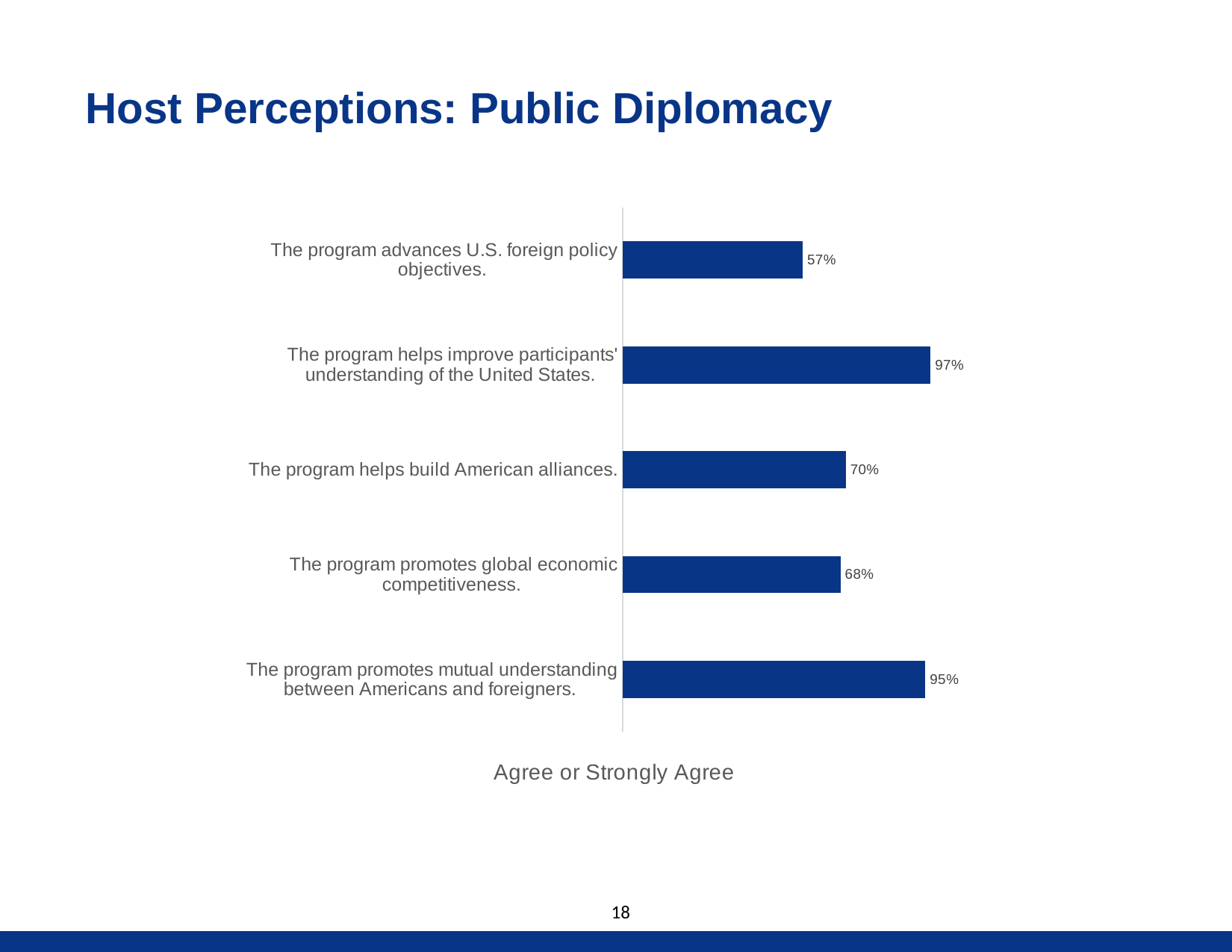
What percentage of hosts agree or strongly agree that the program advances U.S. foreign policy objectives? 57% Which statement has the lowest percentage of hosts agreeing or strongly agreeing? The program advances U.S. foreign policy objectives. What is the title of the slide? Host Perceptions: Public Diplomacy Which statement has the highest percentage of hosts agreeing or strongly agreeing? The program helps improve participants' understanding of the United States. What percentage of hosts agree or strongly agree that the program promotes mutual understanding between Americans and foreigners? 95% What percentage of hosts agree or strongly agree that the program helps build American alliances? 70% How many statements are shown in the chart? 5 Which has a higher agreement percentage: the statement about building American alliances or the statement about promoting global economic competitiveness? The program helps build American alliances. What type of chart is shown on the slide? Bar chart What percentage of hosts agree or strongly agree that the program helps improve participants' understanding of the United States? 97% What is the difference in percentage points between the statement about improving participants' understanding of the United States and the statement about advancing U.S. foreign policy objectives? 40 percentage points What percentage of hosts agree or strongly agree that the program promotes global economic competitiveness? 68%